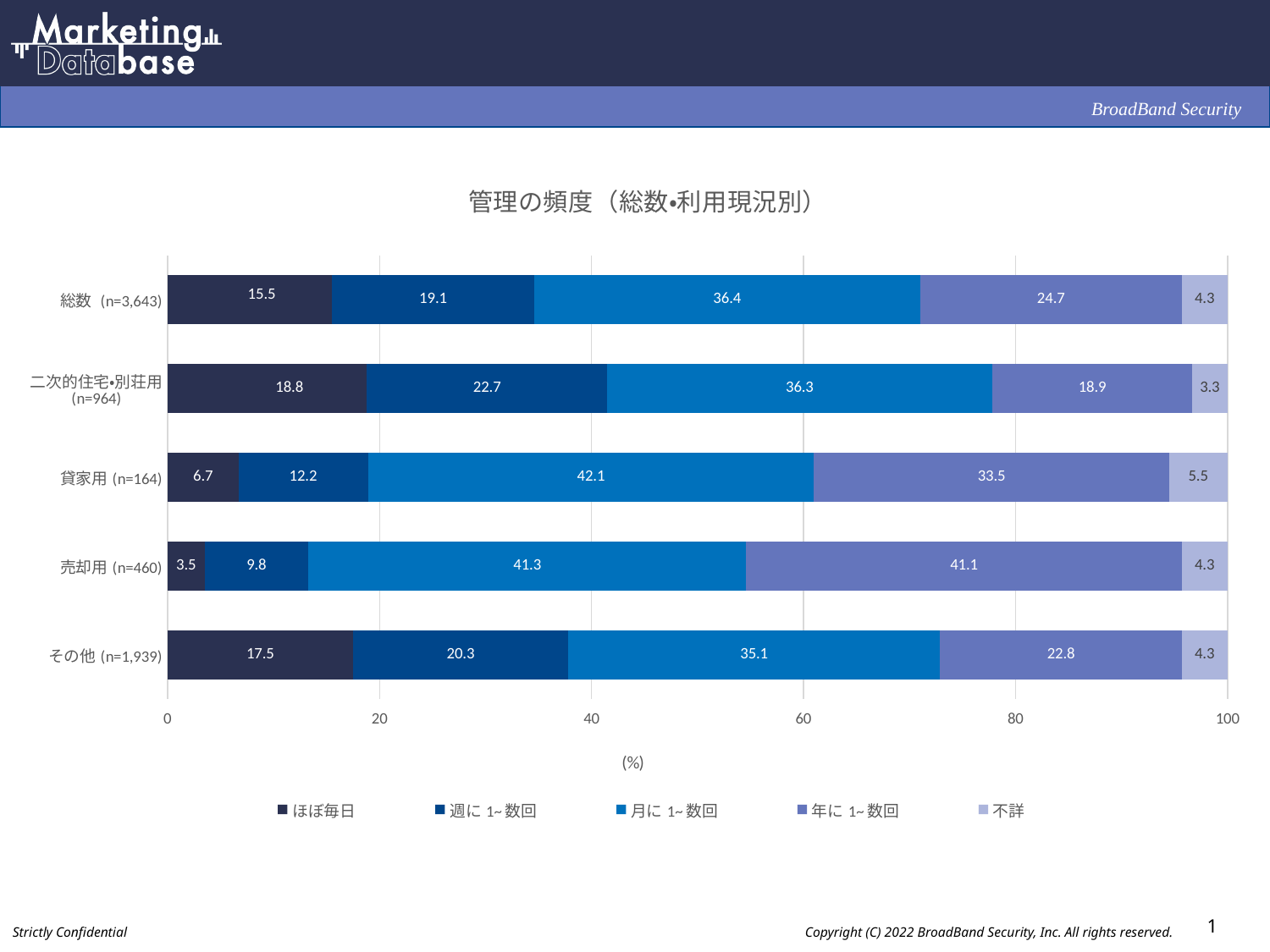
Which category has the lowest value for ほぼ毎日? 売却用 (n=460) What is the title of the chart? 管理の頻度（総数•利用現況別） What is the value of ほぼ毎日 for 総数 (n=3,643)? 15.5 What is the value of 年に1~数回 for 売却用 (n=460)? 41.1 What is the value of 不詳 for 二次的住宅•別荘用 (n=964)? 3.3 What type of chart is shown on the slide? Stacked bar chart What is the value of 月に1~数回 for 貸家用 (n=164)? 42.1 What is the difference between the 週に1~数回 values for 二次的住宅•別荘用 (n=964) and 貸家用 (n=164)? 10.5 How many categories are shown on the chart? 5 Which is larger: the 年に1~数回 value for 貸家用 (n=164) or for その他 (n=1,939)? 貸家用 (n=164) How many series does the legend list? 5 Which category has the highest value for ほぼ毎日? 二次的住宅•別荘用 (n=964)